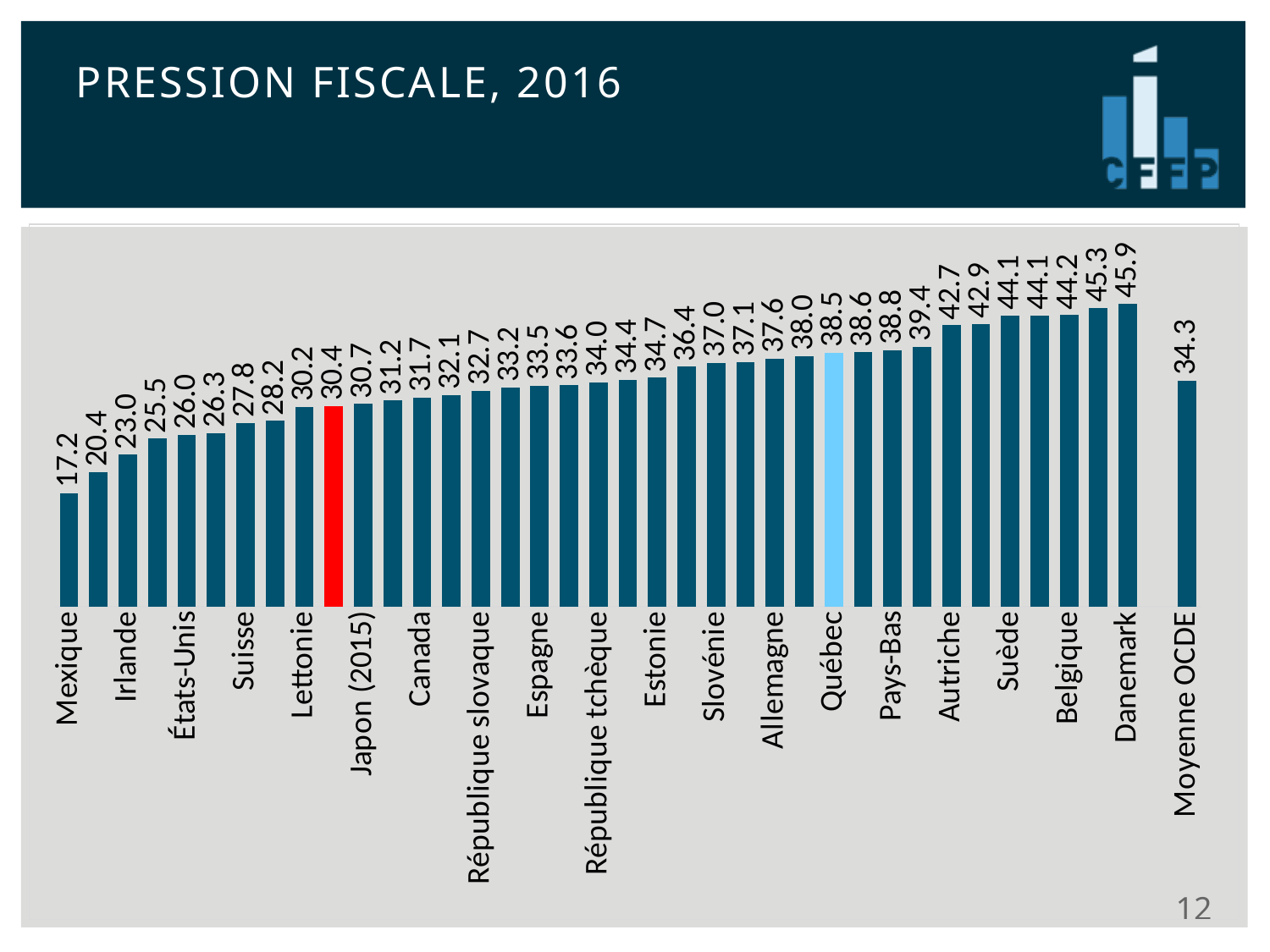
Which country has the highest value on the chart? Danemark What is the value shown for Moyenne OCDE? 34.3 What is the difference between the values for Danemark and Mexique? 28.7 Do the country values rise or fall from left to right across the chart (excluding the Moyenne OCDE bar)? Rise What is the value shown for Canada? 31.7 Which has a larger value, Québec or Canada? Québec What is the difference between the value for Québec and the Moyenne OCDE? 4.2 Which country has the lowest value on the chart? Mexique What is the value shown for Québec? 38.5 What kind of chart is shown on the slide? Bar chart What is the value shown for Mexique? 17.2 What is the title of the slide? PRESSION FISCALE, 2016